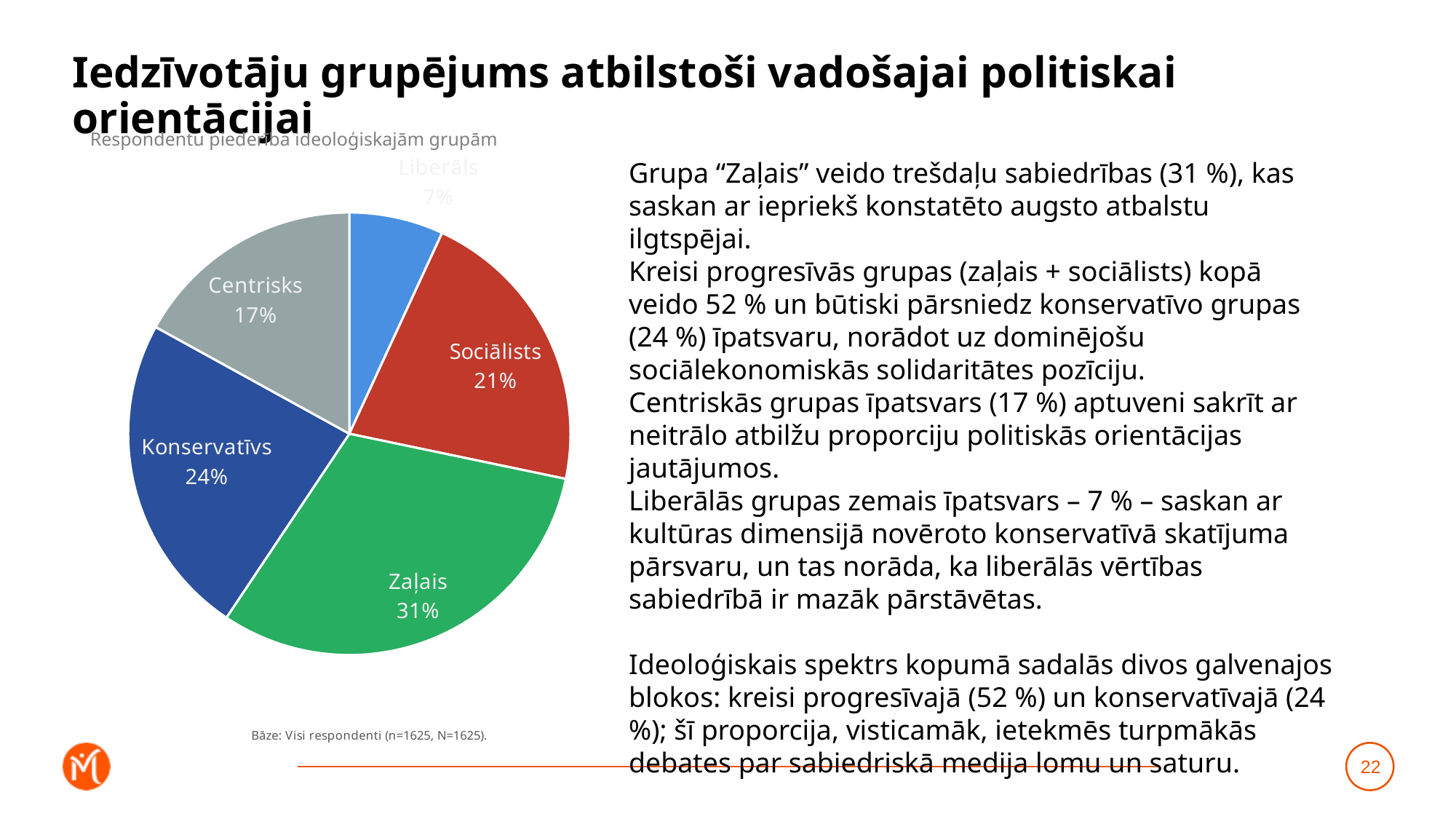
What value is labelled on the Sociālists slice? 21% What type of chart is shown on the slide? Pie chart What percentage is shown for Centrisks? 17% Which slice is larger, Sociālists or Centrisks? Sociālists How many slices does the pie chart have? 5 Which group has the largest share of the pie? Zaļais What is the difference in percentage points between the Zaļais and Konservatīvs slices? 7 Which group has the smallest share of the pie? Liberāls What colour is the Zaļais slice? Green What percentage is shown for the Konservatīvs slice? 24% What share of respondents belongs to the Zaļais group? 31% What is the combined share of the Zaļais and Sociālists slices? 52%